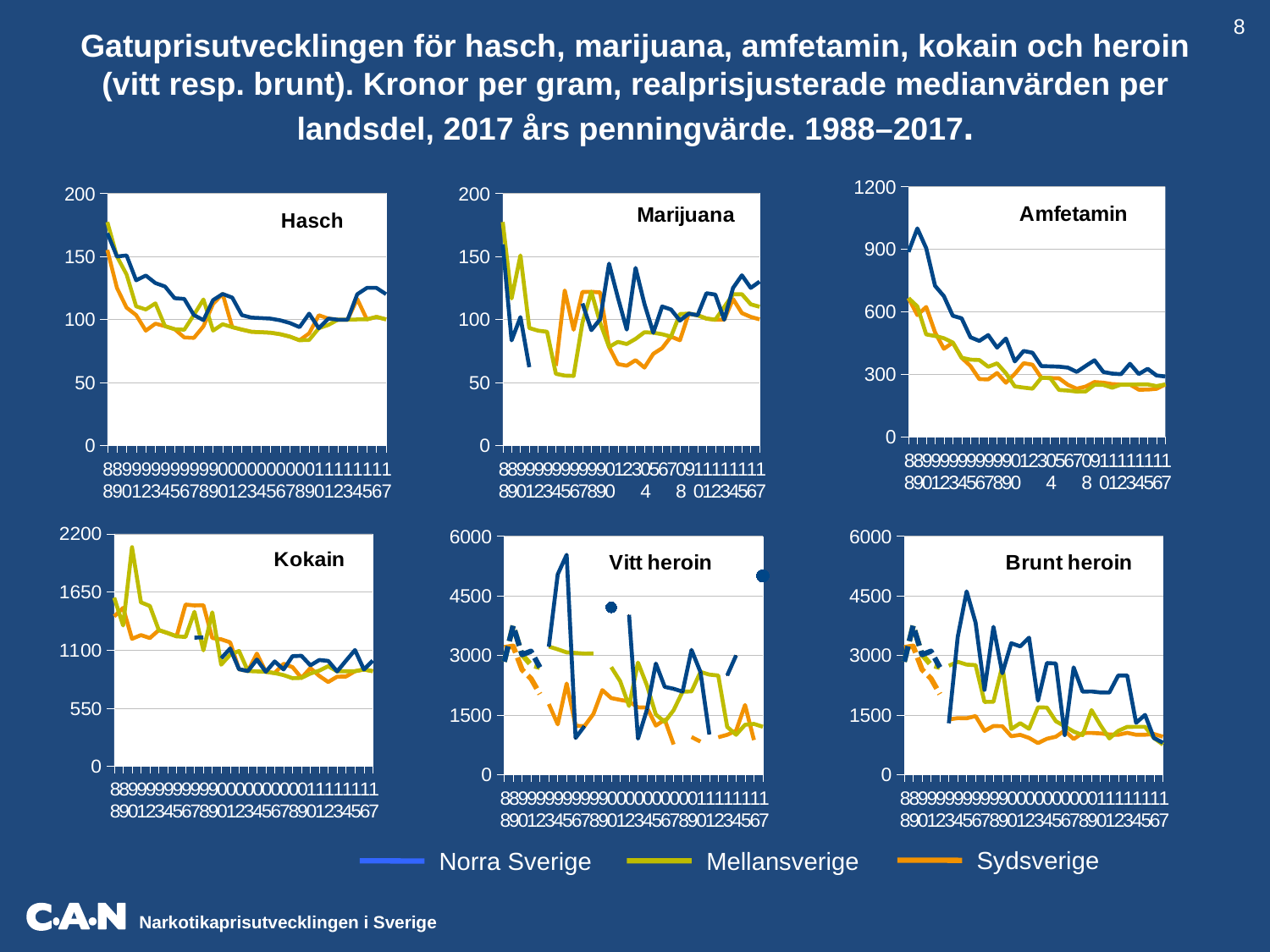
In the Brunt heroin chart, is the highest value for Norra Sverige greater or less than 3000? greater In the Kokain chart, do the values for Mellansverige generally rise or fall over the period? fall In the Amfetamin chart, which series has the highest value at the start of the period? Norra Sverige What is the title of the chart in the top right position? Amfetamin What kind of chart is the Hasch chart? line chart Which series does the orange line represent in the legend? Sydsverige In the Kokain chart, is the highest value for Mellansverige greater or less than 1650? greater In the Amfetamin chart, do the values for Norra Sverige generally rise or fall from 1988 to 2017? fall How many series does the legend at the bottom of the slide list? 3 In the Amfetamin chart, is the highest value for Norra Sverige greater or less than 600? greater How many charts are shown on the slide? 6